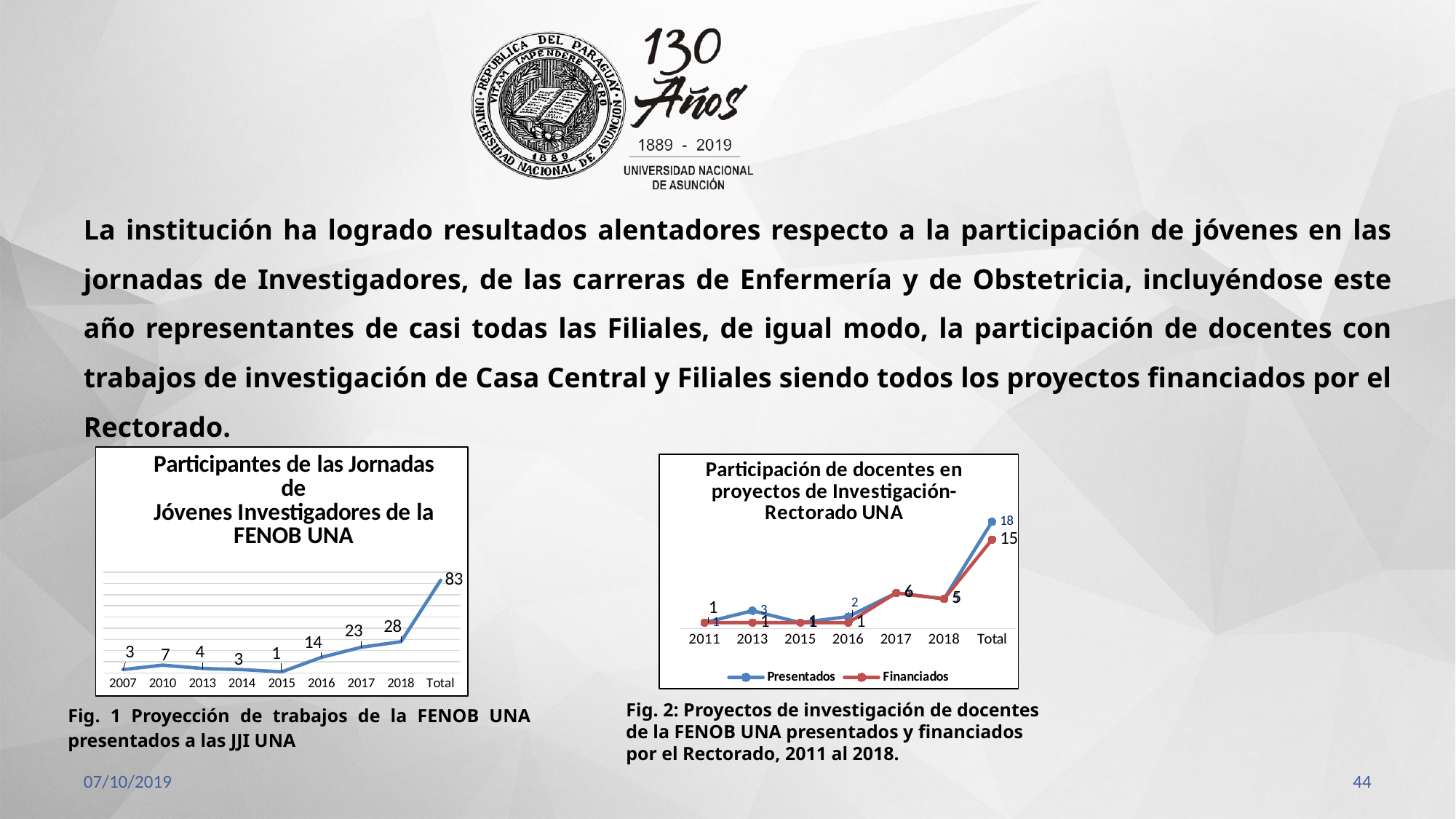
In the chart 'Participantes de las Jornadas de Jóvenes Investigadores de la FENOB UNA', which is larger, the value for 2010 or the value for 2013? 2010 In the chart 'Participantes de las Jornadas de Jóvenes Investigadores de la FENOB UNA', what is the difference between the values for 2018 and 2017? 5 In the chart 'Participación de docentes en proyectos de Investigación-Rectorado UNA', what is the difference between the Presentados and Financiados values for Total? 3 How many categories are shown on the x axis of the chart 'Participantes de las Jornadas de Jóvenes Investigadores de la FENOB UNA'? 9 In the chart 'Participantes de las Jornadas de Jóvenes Investigadores de la FENOB UNA', what is the value for 2015? 1 In the chart 'Participación de docentes en proyectos de Investigación-Rectorado UNA', what is the Financiados value for Total? 15 What kind of chart is 'Participantes de las Jornadas de Jóvenes Investigadores de la FENOB UNA'? Line chart In the chart 'Participación de docentes en proyectos de Investigación-Rectorado UNA', which colour is the Financiados line? Red How many series does the legend list in the chart 'Participación de docentes en proyectos de Investigación-Rectorado UNA'? 2 In the chart 'Participantes de las Jornadas de Jóvenes Investigadores de la FENOB UNA', what is the value for 2017? 23 In the chart 'Participantes de las Jornadas de Jóvenes Investigadores de la FENOB UNA', which year has the lowest value? 2015 In the chart 'Participación de docentes en proyectos de Investigación-Rectorado UNA', what is the Presentados value for 2013? 3